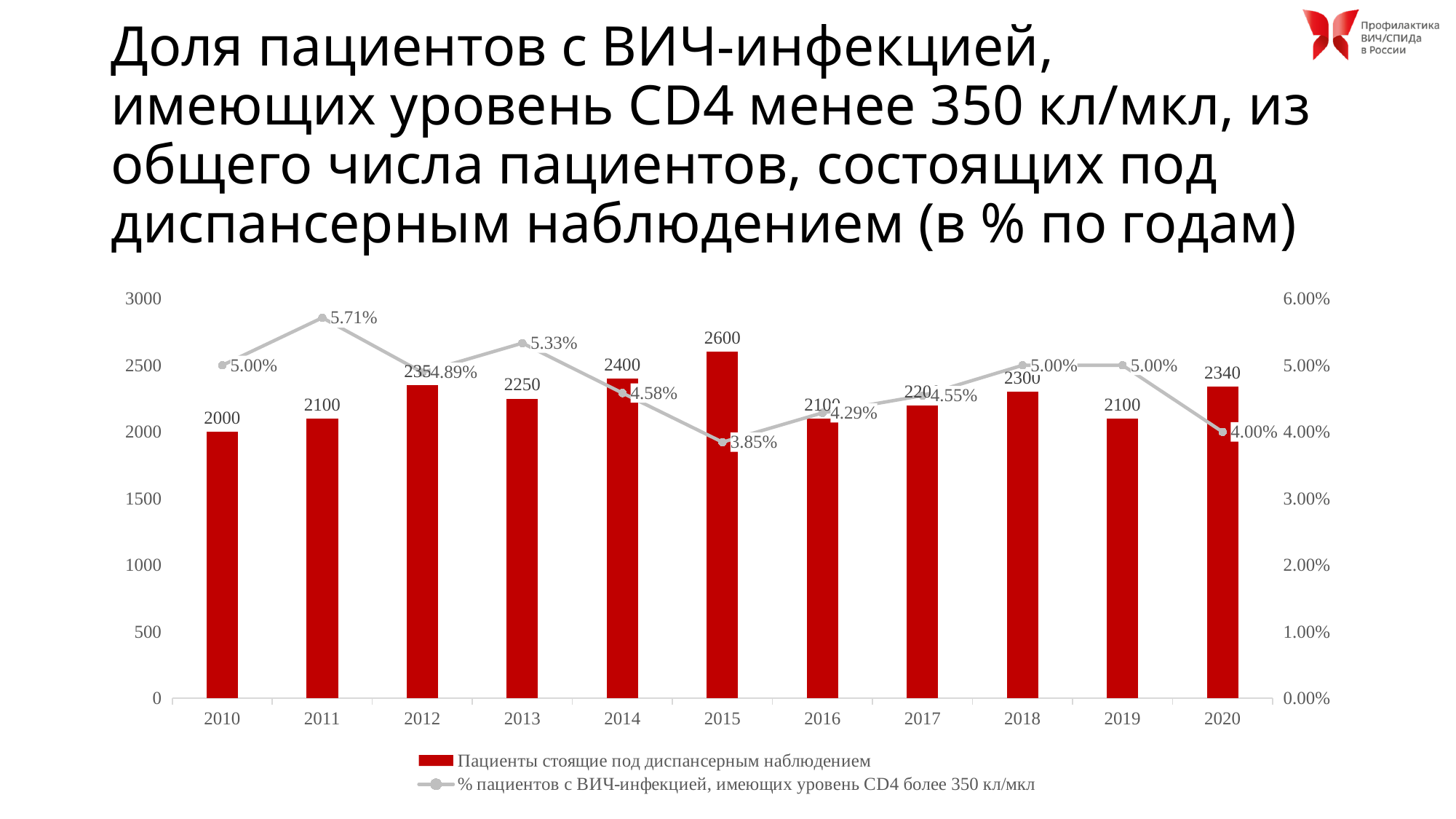
What is the value of the bar for 2015? 2600 What percentage does the line series show for 2020? 4.00% Which year has the lowest bar value? 2010 What is the difference between the bar values for 2015 and 2014? 200 What kind of chart is shown on the slide? Combined bar and line chart Which year has the highest bar value? 2015 How many years are shown on the x axis? 11 Is the bar value for 2020 greater or less than 2500? less Which year has the larger bar value, 2013 or 2014? 2014 In which year is the line series (percentage) at its lowest? 2015 What percentage does the line series show for 2011? 5.71% In which year is the line series (percentage) at its highest? 2011